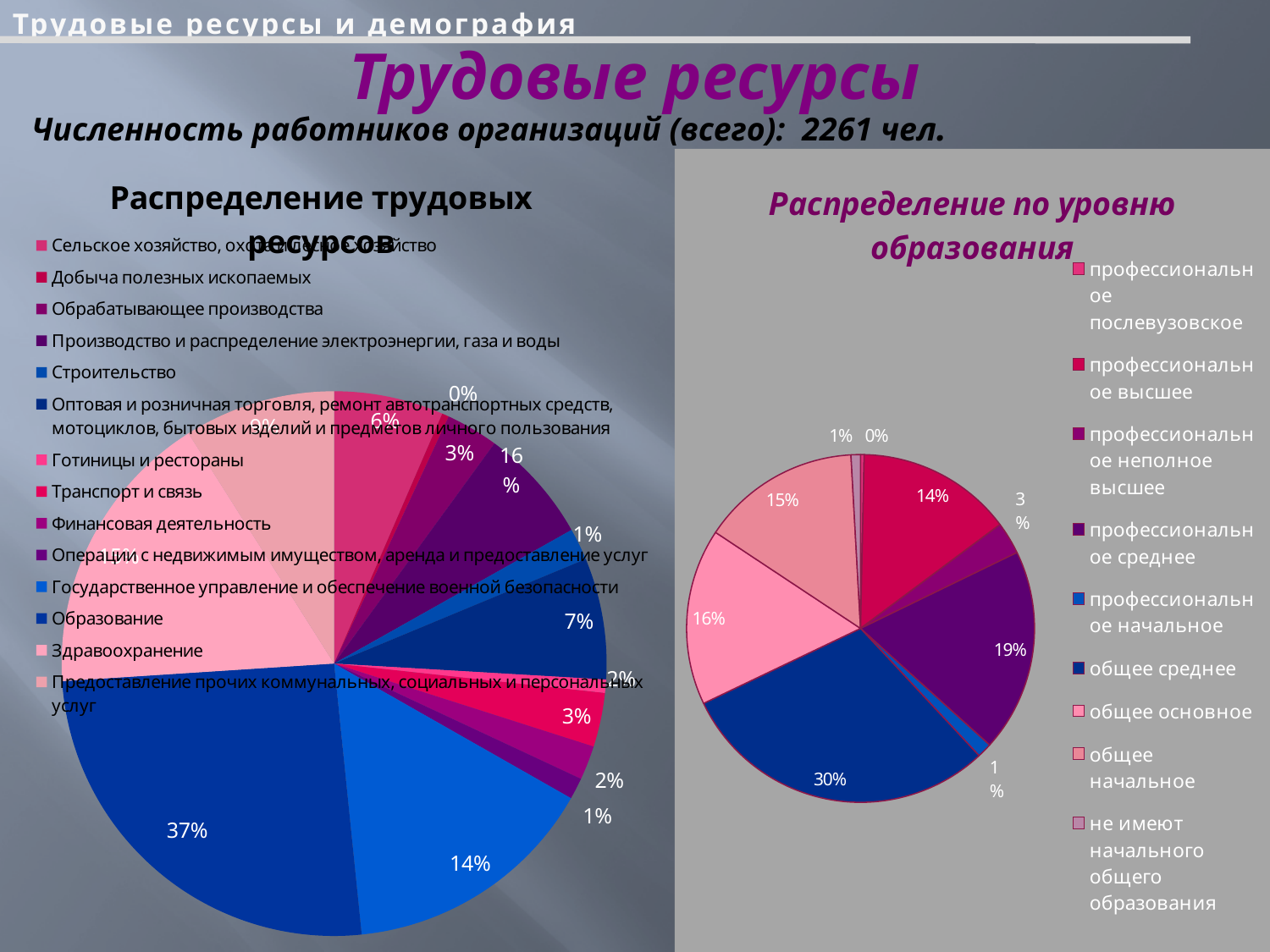
In the "Распределение по уровню образования" chart, what is the difference between "общее среднее" and "общее основное"? 14% In the "Распределение трудовых ресурсов" chart, which category has the largest share? Образование In the "Распределение трудовых ресурсов" chart, what is the difference between "Образование" and "Государственное управление и обеспечение военной безопасности"? 23% What kind of chart is used for "Распределение по уровню образования"? pie chart How many categories does the legend of the "Распределение трудовых ресурсов" chart list? 14 In the "Распределение по уровню образования" chart, what share is "профессиональное среднее"? 19% In the "Распределение по уровню образования" chart, what share is "профессиональное высшее"? 14% In the "Распределение трудовых ресурсов" chart, what share is "Государственное управление и обеспечение военной безопасности"? 14% How many categories does the legend of the "Распределение по уровню образования" chart list? 9 In the "Распределение по уровню образования" chart, which is larger: "общее основное" or "общее начальное"? общее основное In the "Распределение по уровню образования" chart, which category has the largest share? общее среднее